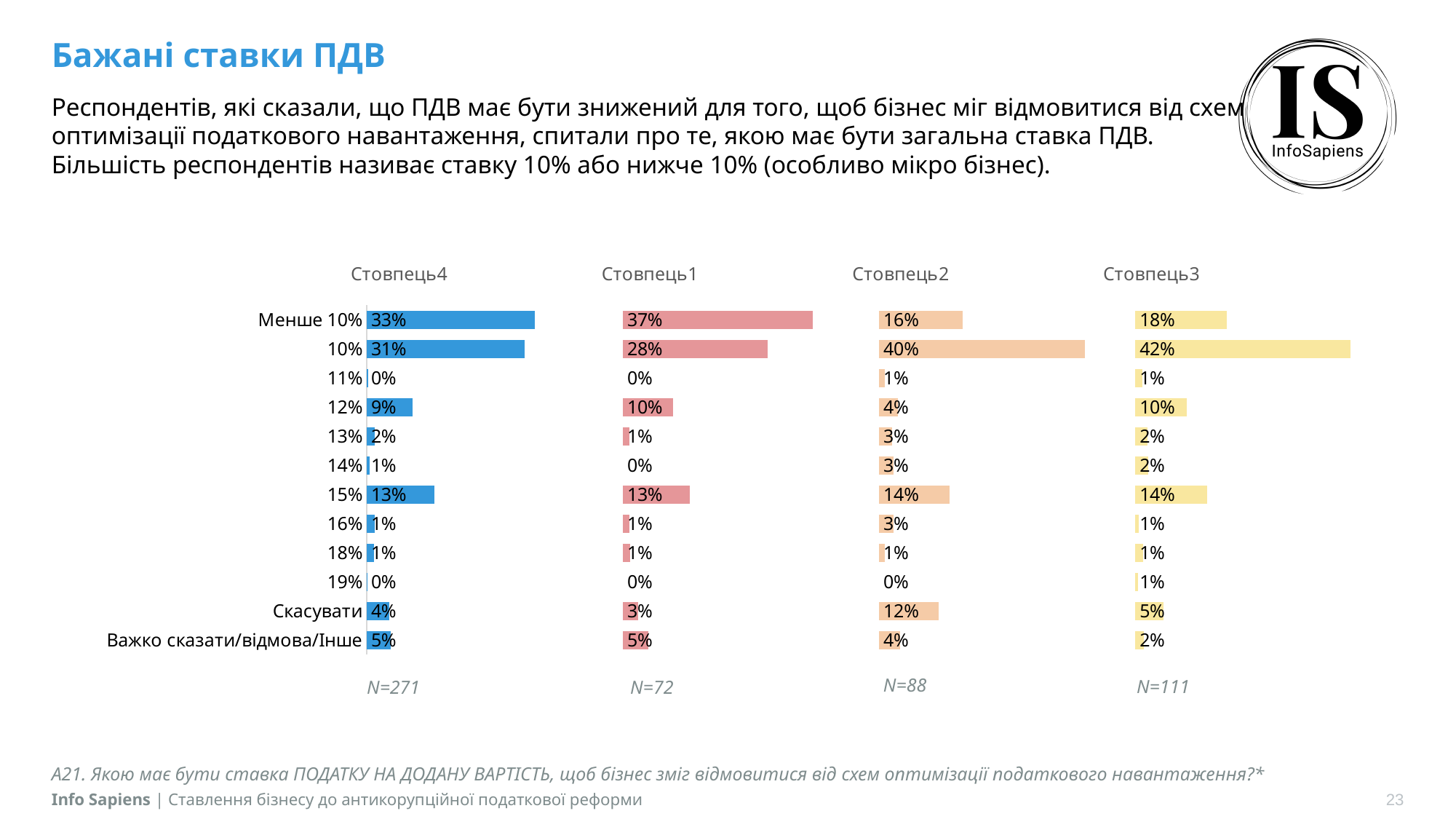
What is the value for "Менше 10%" in the Стовпець1 series? 37% What kind of chart is shown on the slide? Bar chart What is the value for "Скасувати" in the Стовпець2 series? 12% Which category has the highest value in the Стовпець2 series? 10% What is the value for "10%" in the Стовпець3 series? 42% Which category has the highest value in the Стовпець4 series? Менше 10% Which is larger in the Стовпець3 series: the value for "12%" or the value for "15%"? 15% What is the difference between the values for "Менше 10%" and "10%" in the Стовпець1 series? 9% How many categories are shown on the chart? 12 What is the sample size (N) shown for the Стовпець4 series? N=271 What is the value for "15%" in the Стовпець4 series? 13% How many series does the chart show? 4